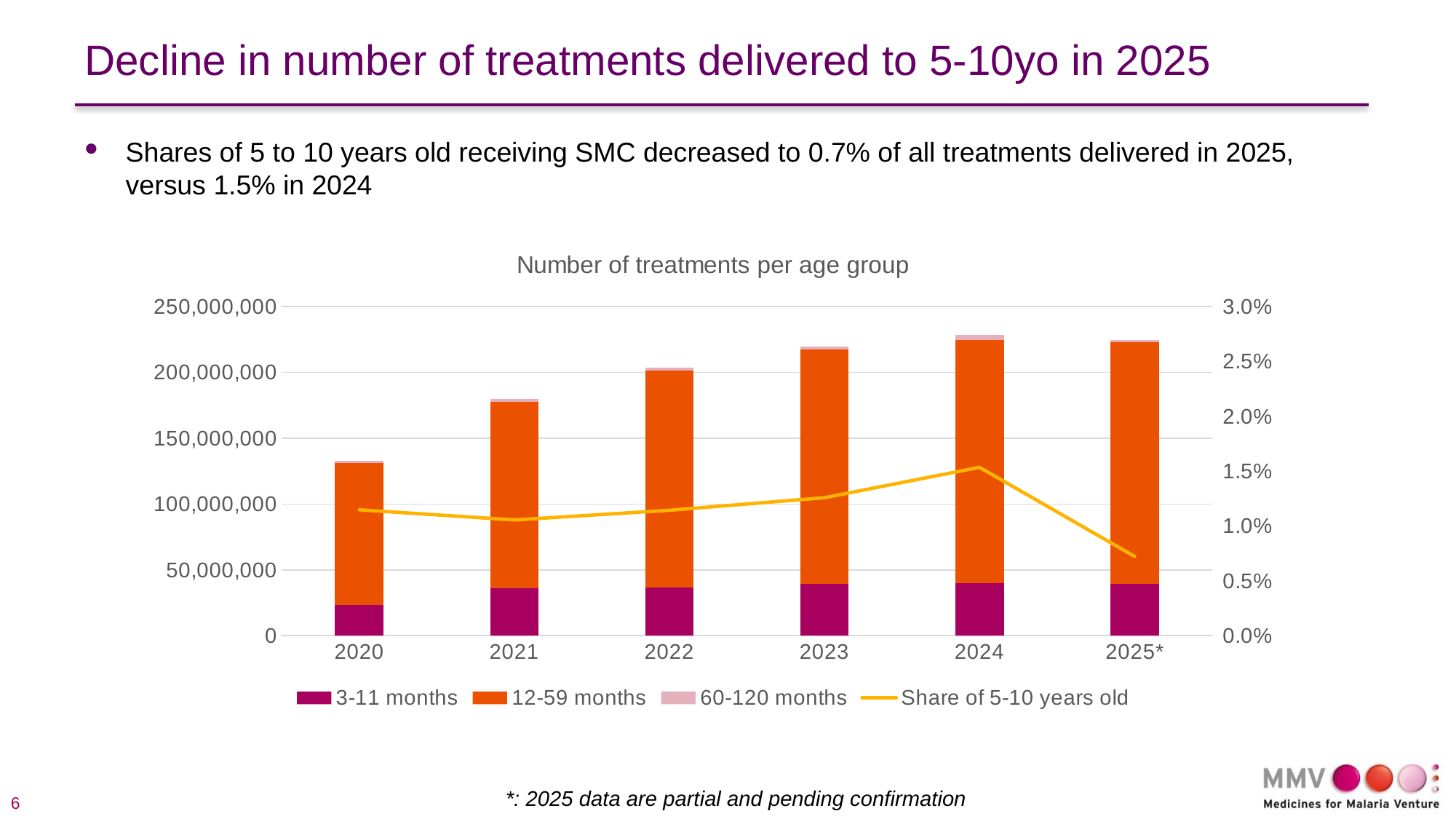
Is the share of 5-10 years old in 2025* greater or less than 1.0%? less Does the share of 5-10 years old line rise or fall from 2024 to 2025*? fall How many years are shown on the x axis of the chart? 6 What kind of chart is shown on the slide? Stacked bar chart with a line Which year has the highest total number of treatments? 2024 Which is larger, the total number of treatments in 2022 or in 2021? 2022 Which year has the lowest total number of treatments? 2020 How many series does the chart legend list? 4 Is the total number of treatments in 2021 greater or less than 200,000,000? less Is the total number of treatments in 2020 greater or less than 100,000,000? greater What is the title of the chart? Number of treatments per age group